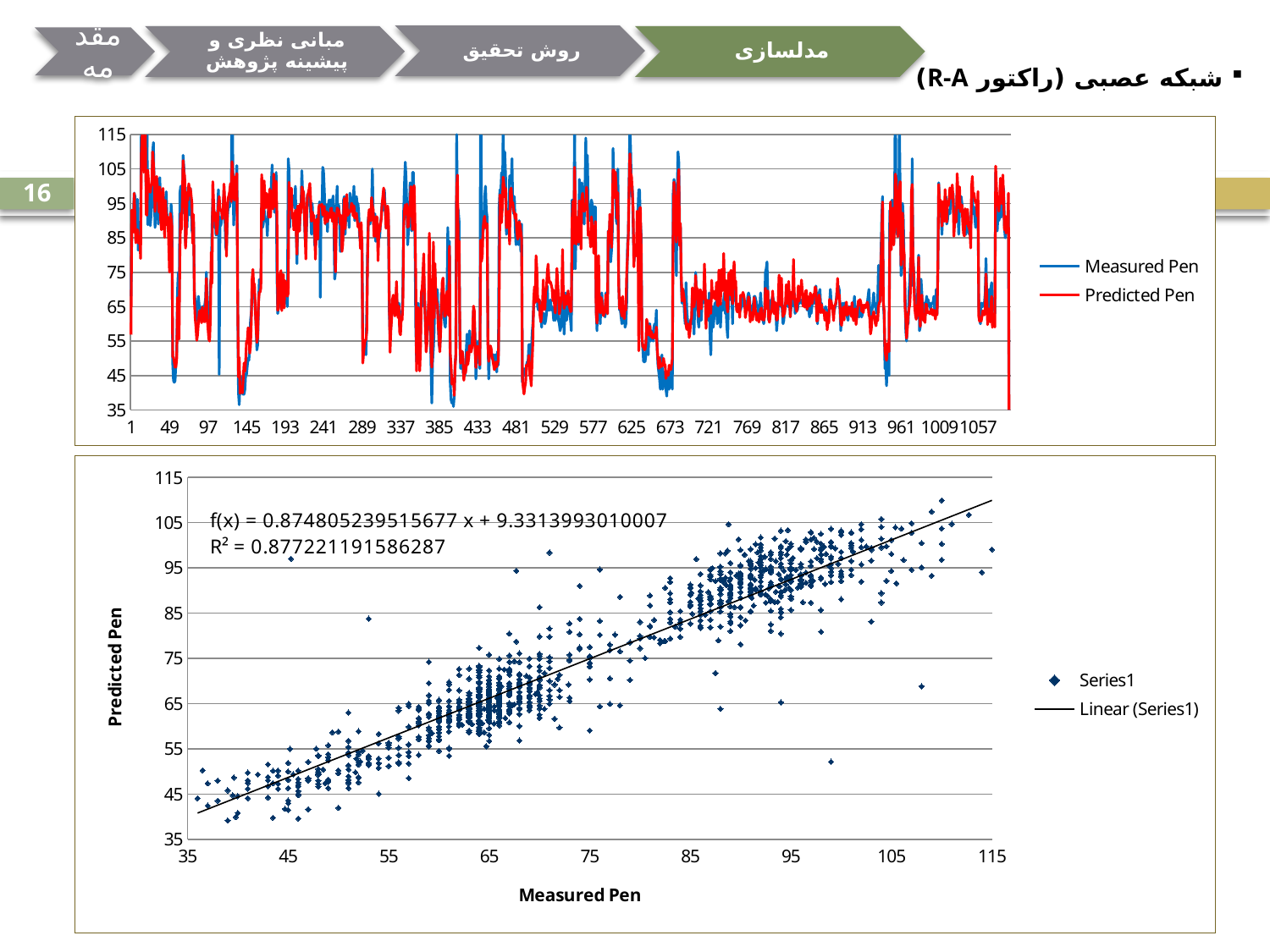
In the bottom chart, what is the title of the horizontal axis? Measured Pen In the bottom chart, is the fitted line's value at Measured Pen 35 greater or less than 45? less What kind of chart is the top chart on the slide? line chart How many series does the legend of the top chart list? 2 In the bottom chart, what is the slope of the fitted line f(x)? 0.874805239515677 In the bottom chart, what is the intercept of the fitted line f(x)? 9.3313993010007 In the bottom chart, is the fitted line's value at Measured Pen 115 greater or less than 105? greater In the bottom chart, do the Predicted Pen values rise or fall as Measured Pen increases? rise In the bottom chart, what is the R² value shown for the linear fit? 0.877221191586287 How many entries does the legend of the bottom chart list? 2 In the top chart, what colour is the Predicted Pen line? red What kind of chart is the bottom chart on the slide? scatter chart